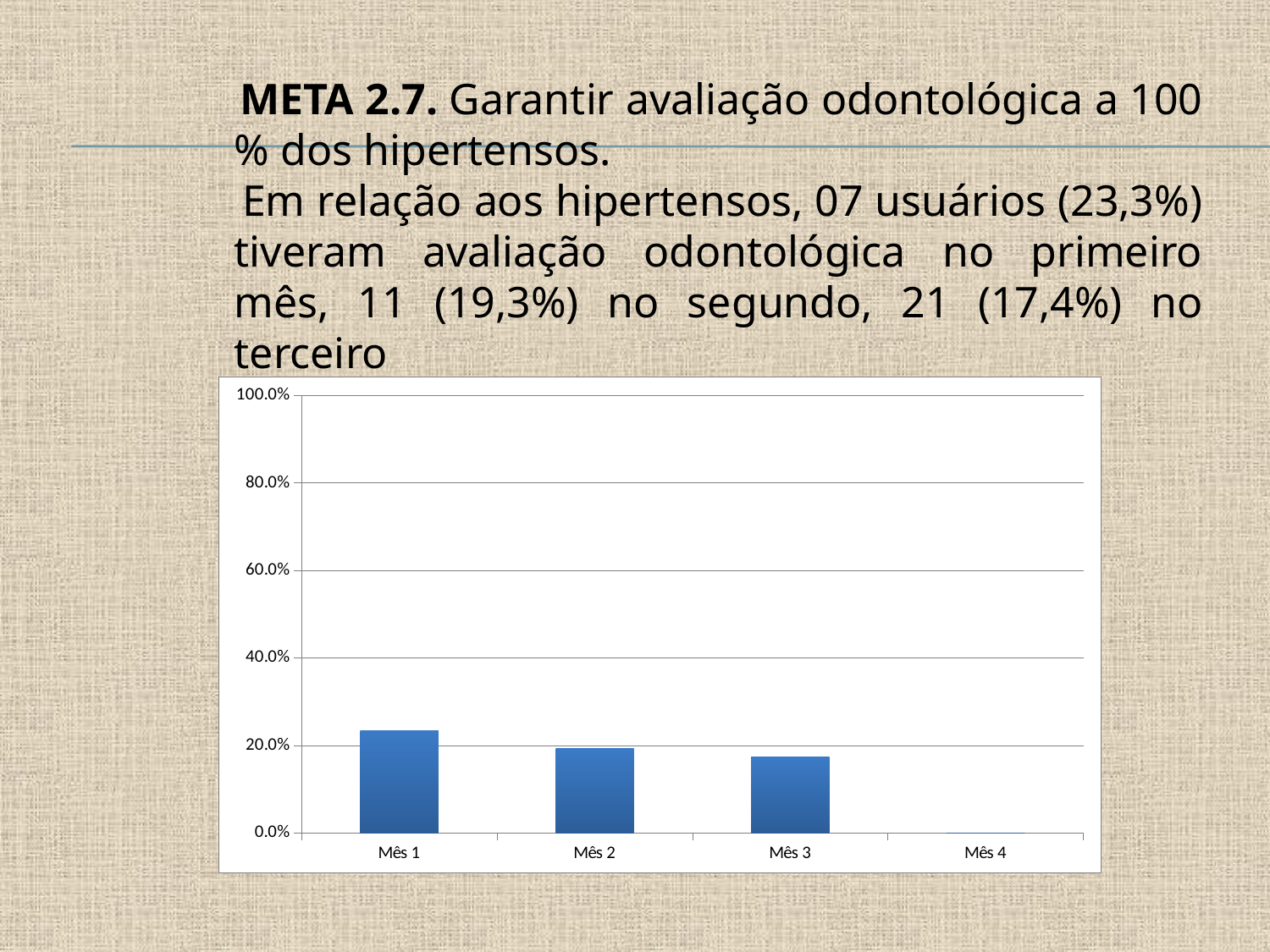
Is the value for Mês 3 greater or less than 20.0%? less What is the highest value shown on the y axis of the chart? 100.0% Is the value for Mês 1 greater or less than 40.0%? less Which month has the highest bar in the chart? Mês 1 How many categories are shown on the x axis of the chart? 4 What kind of chart is shown on the slide? bar chart Is the value for Mês 1 greater or less than 20.0%? greater Do the values rise or fall from Mês 1 to Mês 4? fall Which is larger, the value for Mês 1 or the value for Mês 3? Mês 1 Which is larger, the value for Mês 2 or the value for Mês 4? Mês 2 Which month has the lowest bar in the chart? Mês 4